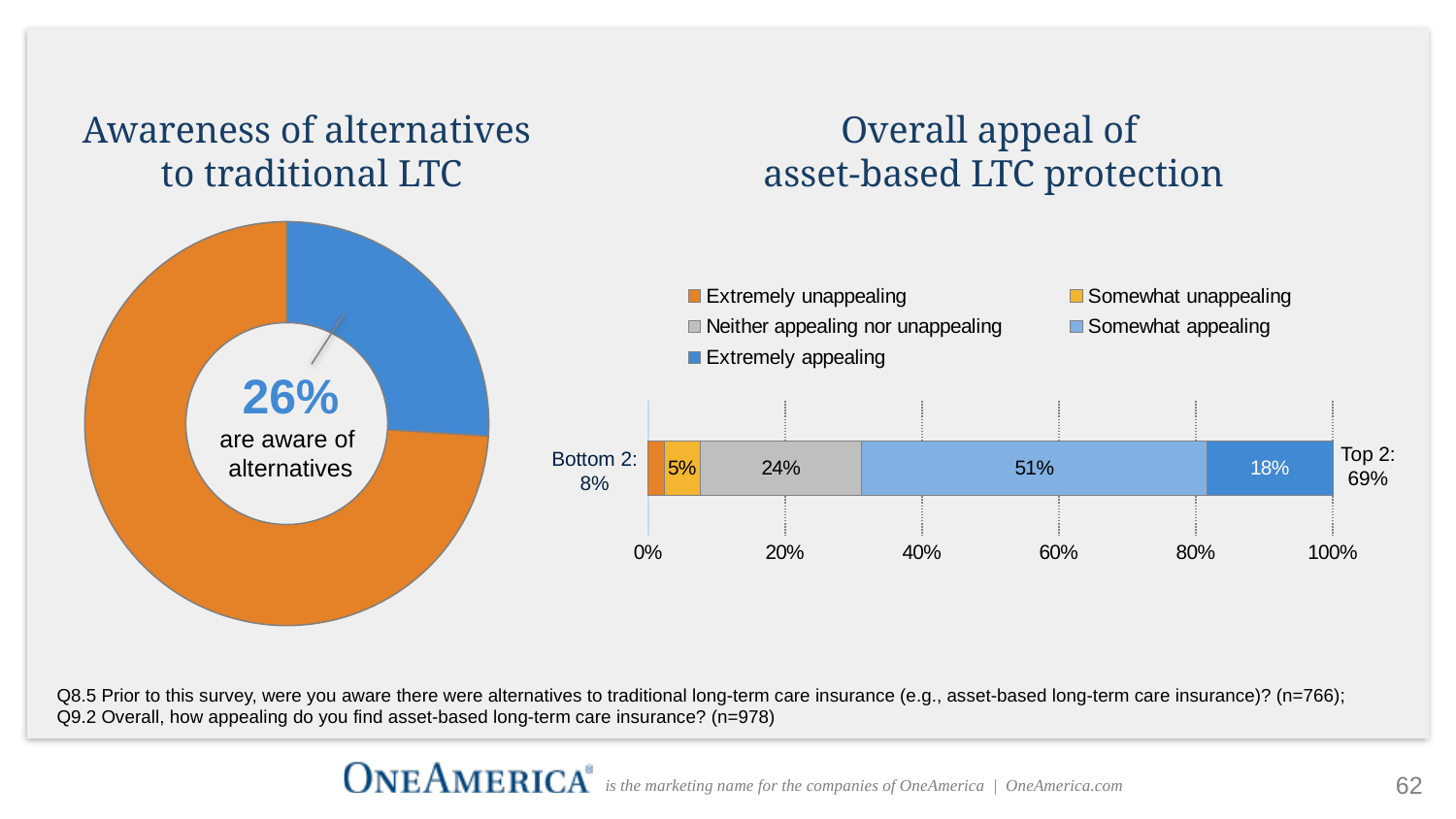
In the 'Overall appeal of asset-based LTC protection' chart, what is the difference between 'Somewhat appealing' and 'Extremely appealing'? 33 percentage points In the 'Overall appeal of asset-based LTC protection' chart, what is the value for 'Extremely appealing'? 18% In the 'Overall appeal of asset-based LTC protection' chart, which response category has the smallest share? Extremely unappealing What kind of chart is the 'Awareness of alternatives to traditional LTC' chart? donut (pie) chart In the 'Overall appeal of asset-based LTC protection' chart, what is the value for 'Somewhat unappealing'? 5% In the 'Overall appeal of asset-based LTC protection' chart, what is the 'Top 2' value shown? 69% How many series does the legend of the 'Overall appeal of asset-based LTC protection' chart list? 5 In the 'Overall appeal of asset-based LTC protection' chart, what is the value for 'Neither appealing nor unappealing'? 24% In the 'Awareness of alternatives to traditional LTC' chart, what percentage are aware of alternatives? 26% What kind of chart is the 'Overall appeal of asset-based LTC protection' chart? stacked bar chart In the 'Overall appeal of asset-based LTC protection' chart, which response category has the largest share? Somewhat appealing In the 'Overall appeal of asset-based LTC protection' chart, what is the value for 'Somewhat appealing'? 51%